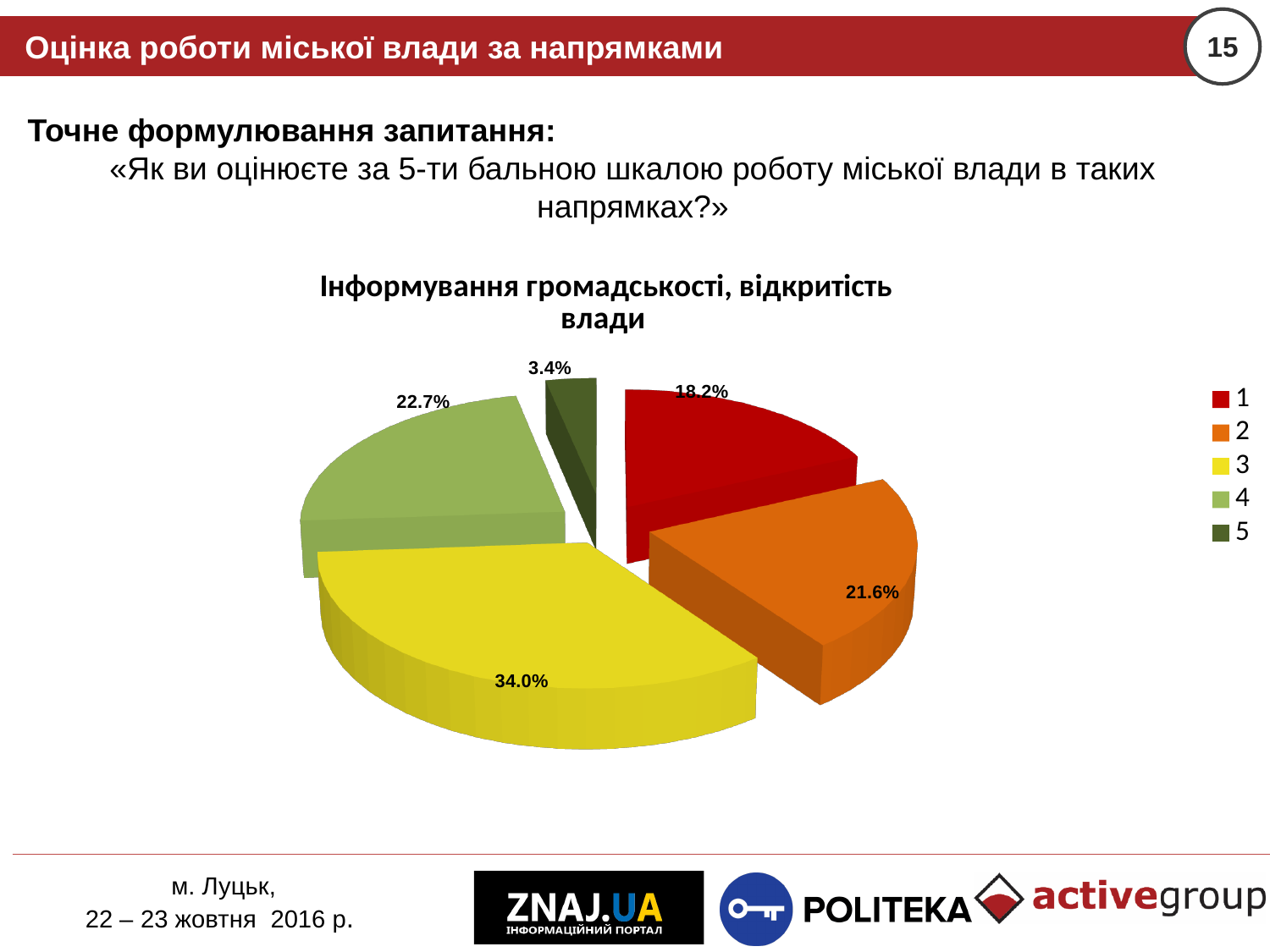
Which rating has the largest slice of the pie? 3 Which rating has the smallest slice of the pie? 5 How many slices does the pie chart have? 5 What share of the pie does rating 3 have? 34.0% What is the difference between the shares for rating 3 and rating 2? 12.4% What is the title of the chart? Інформування громадськості, відкритість влади What share of the pie does rating 1 have? 18.2% What colour is the slice for rating 2? Orange What share of the pie does rating 5 have? 3.4% What type of chart is shown on the slide? Pie chart What share of the pie does rating 4 have? 22.7% Which is larger, the share for rating 4 or the share for rating 1? Rating 4